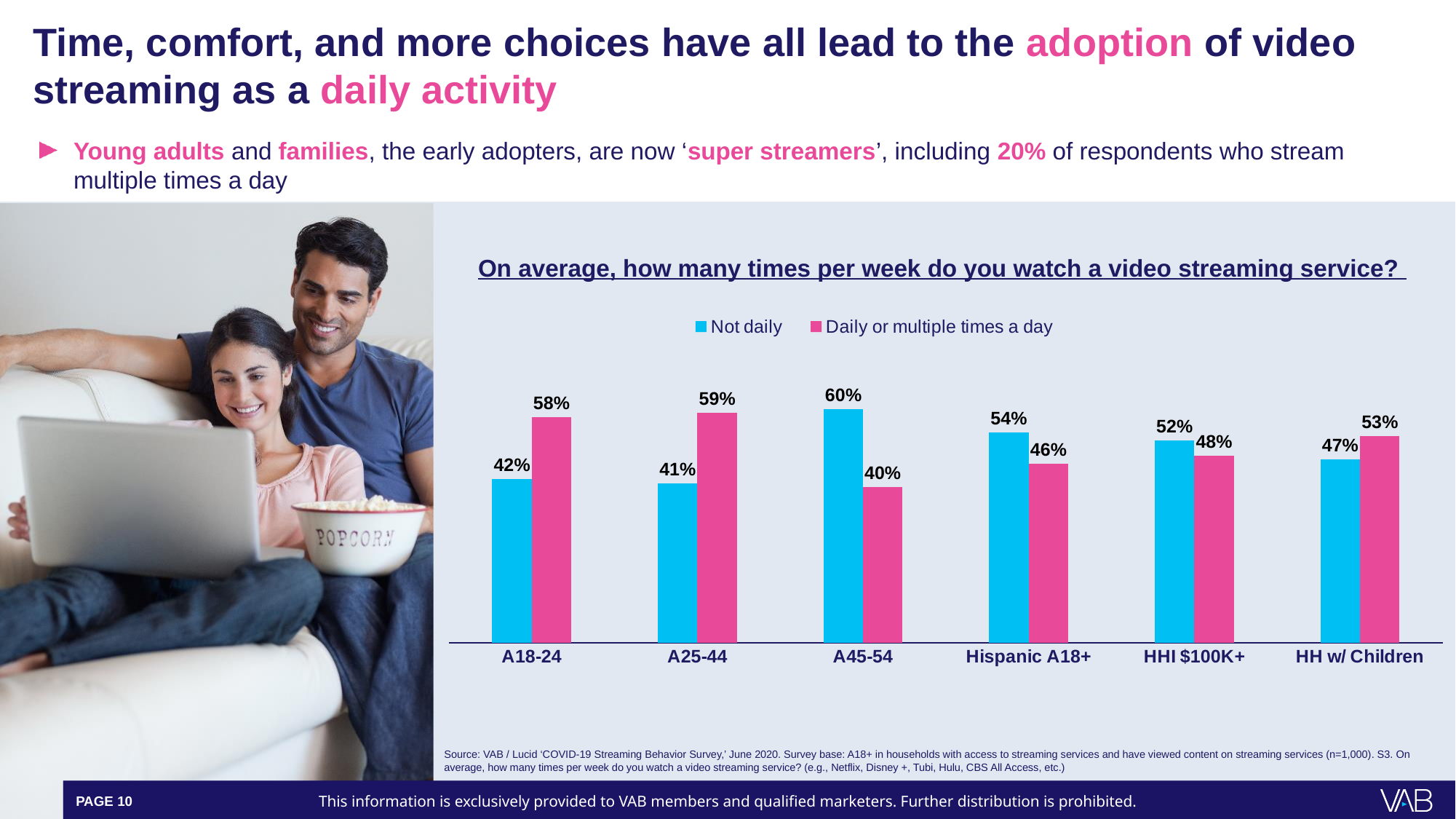
How many series does the legend list? 2 Which category has the lowest 'Not daily' value? A25-44 What is the 'Daily or multiple times a day' value for A18-24? 58% What is the difference between the 'Not daily' and 'Daily or multiple times a day' values for A45-54? 20% For HHI $100K+, which is larger: 'Not daily' or 'Daily or multiple times a day'? Not daily Which category has the highest 'Daily or multiple times a day' value? A25-44 What colour represents the 'Not daily' series? Blue What kind of chart is shown on the slide? Bar chart How many categories are shown on the x axis? 6 What is the 'Not daily' value for HH w/ Children? 47% What is the 'Not daily' value for A45-54? 60% What is the 'Daily or multiple times a day' value for Hispanic A18+? 46%